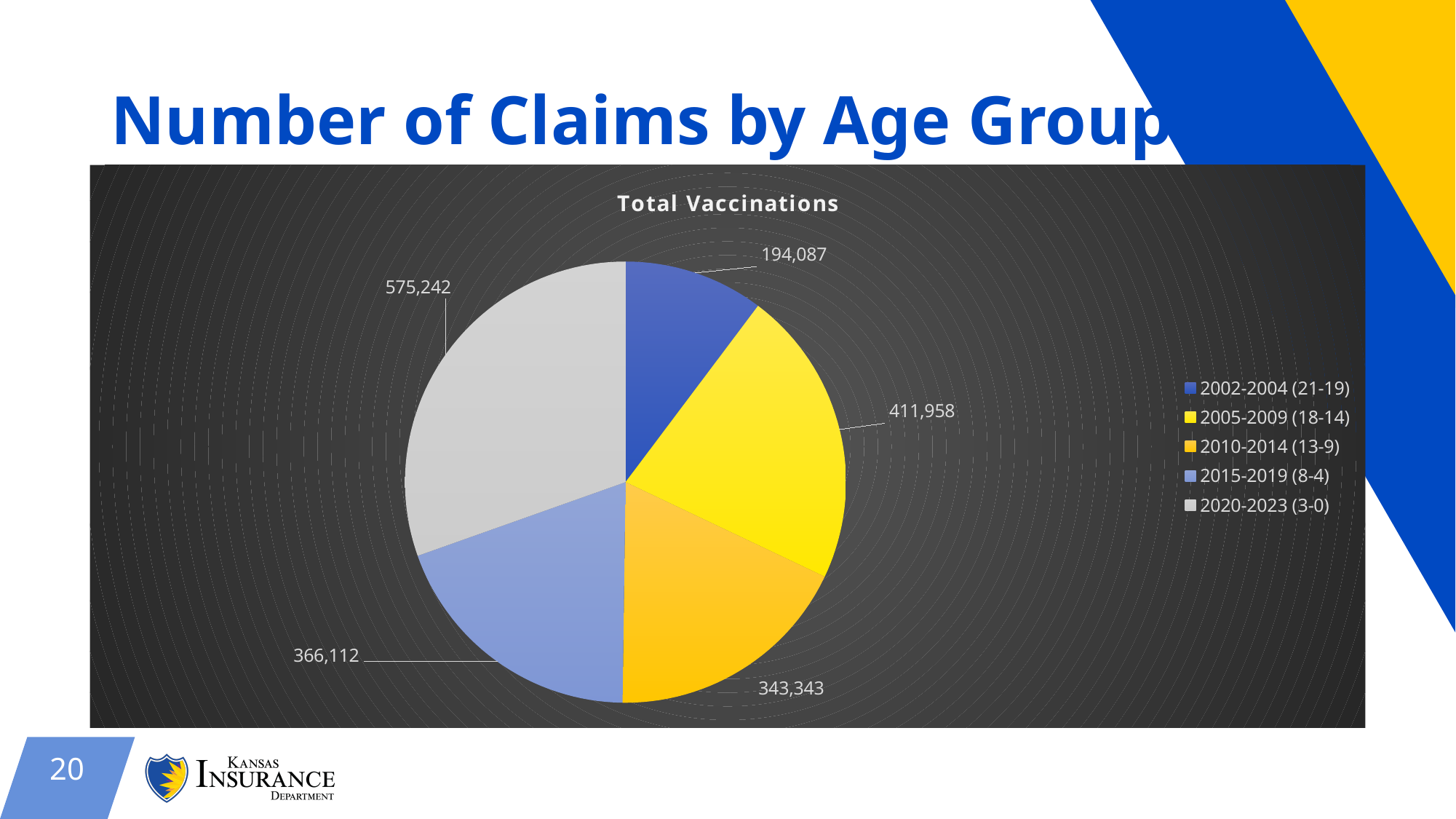
How many age groups are shown in the pie chart? 5 What is the difference between the values for 2005-2009 (18-14) and 2010-2014 (13-9)? 68,615 What is the value for the 2015-2019 (8-4) age group? 366,112 Which age group has the largest slice of the pie? 2020-2023 (3-0) Which is larger, the value for 2005-2009 (18-14) or the value for 2015-2019 (8-4)? 2005-2009 (18-14) What is the difference between the values for 2020-2023 (3-0) and 2002-2004 (21-19)? 381,155 What is the title of the chart? Total Vaccinations What is the value for the 2020-2023 (3-0) age group in the Total Vaccinations pie chart? 575,242 What is the value for the 2010-2014 (13-9) age group? 343,343 Which age group has the smallest slice of the pie? 2002-2004 (21-19) What is the value for the 2002-2004 (21-19) age group? 194,087 What kind of chart is shown on the slide? Pie chart